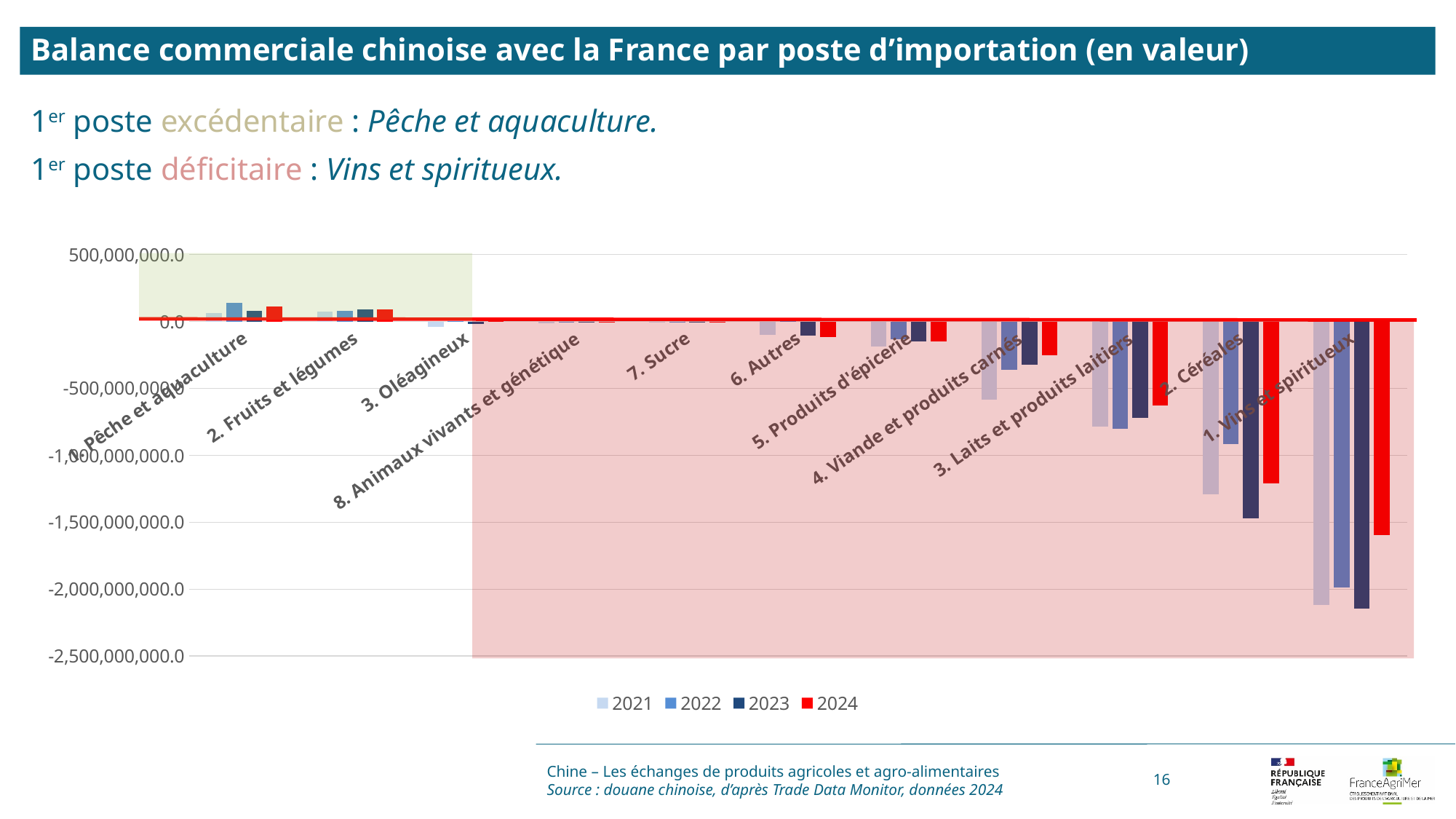
Is the 2024 value for 4. Viande et produits carnés greater or less than -500,000,000.0? greater Which colour represents the 2024 series in the legend? red Which category has the lowest (most negative) value in the chart? 1. Vins et spiritueux Is the 2023 value for 2. Céréales greater or less than -1,000,000,000.0? less For 1. Vins et spiritueux, which year has the larger (less negative) value, 2023 or 2024? 2024 What kind of chart is shown on the slide? bar chart Do the values generally rise or fall moving from left to right along the x axis? fall Is the 2023 value for 1. Vins et spiritueux greater or less than -2,000,000,000.0? less Which category has the highest value in the chart? 1. Pêche et aquaculture For 2. Céréales, which year has the lower (more negative) value, 2021 or 2022? 2021 How many product categories are plotted on the x axis? 11 How many series does the legend list? 4